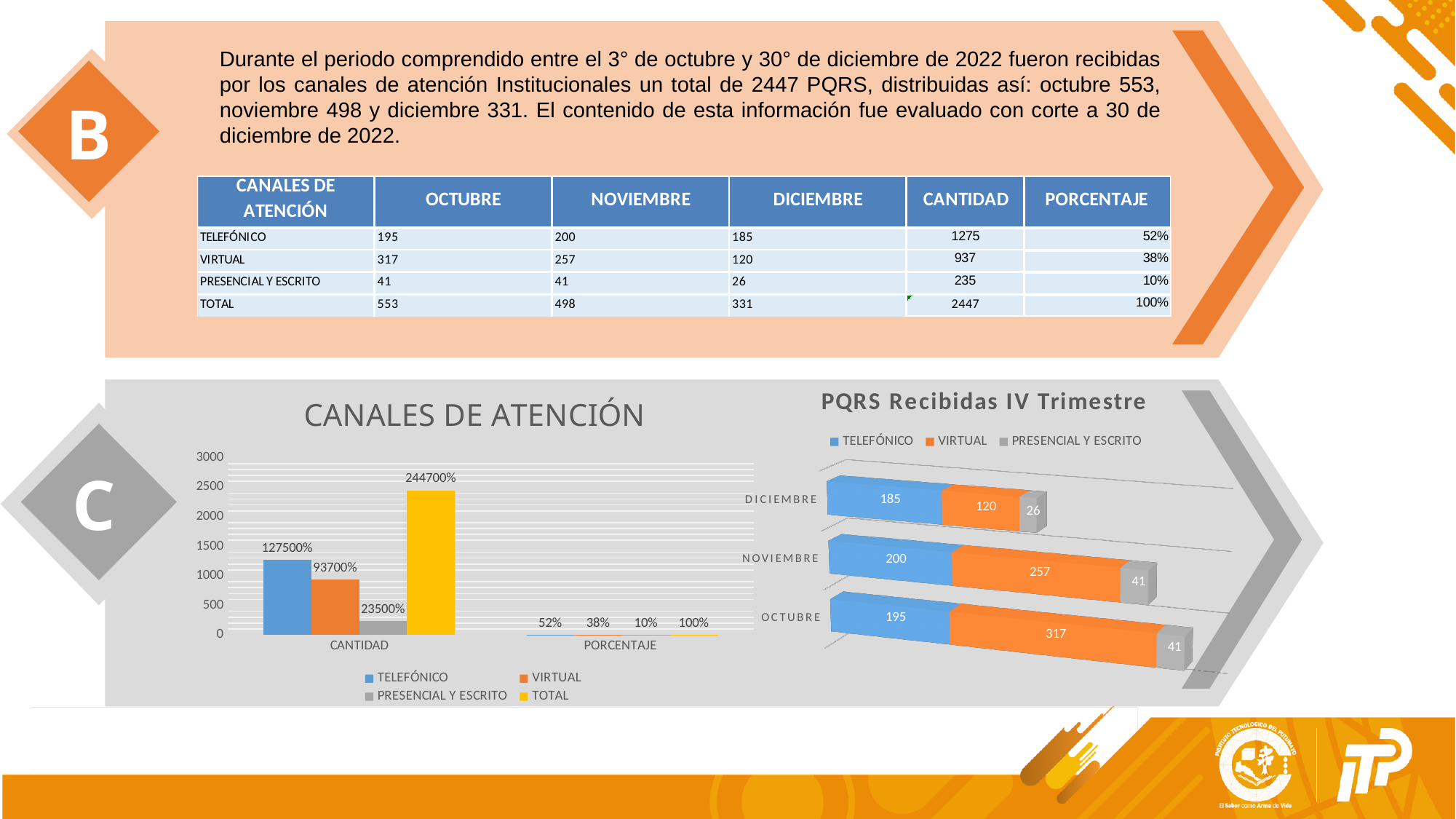
In the 'PQRS Recibidas IV Trimestre' chart, what is the value for PRESENCIAL Y ESCRITO in DICIEMBRE? 26 In the 'PQRS Recibidas IV Trimestre' chart, which month has the highest VIRTUAL value? OCTUBRE In the 'CANALES DE ATENCIÓN' chart, what data label is shown for VIRTUAL under PORCENTAJE? 38% In the 'PQRS Recibidas IV Trimestre' chart, what is the total of the stacked bar for OCTUBRE? 553 How many series does the legend of the 'PQRS Recibidas IV Trimestre' chart list? 3 In the 'PQRS Recibidas IV Trimestre' chart, what is the value for TELEFÓNICO in OCTUBRE? 195 In the 'PQRS Recibidas IV Trimestre' chart, what is the value for VIRTUAL in NOVIEMBRE? 257 What kind of chart is 'PQRS Recibidas IV Trimestre'? Stacked bar chart How many series does the legend of the 'CANALES DE ATENCIÓN' chart list? 4 In the 'CANALES DE ATENCIÓN' chart, what data label is shown for TOTAL under CANTIDAD? 244700% In the 'PQRS Recibidas IV Trimestre' chart, what is the difference between VIRTUAL in OCTUBRE and VIRTUAL in DICIEMBRE? 197 In the 'PQRS Recibidas IV Trimestre' chart, what is the total of the stacked bar for DICIEMBRE? 331